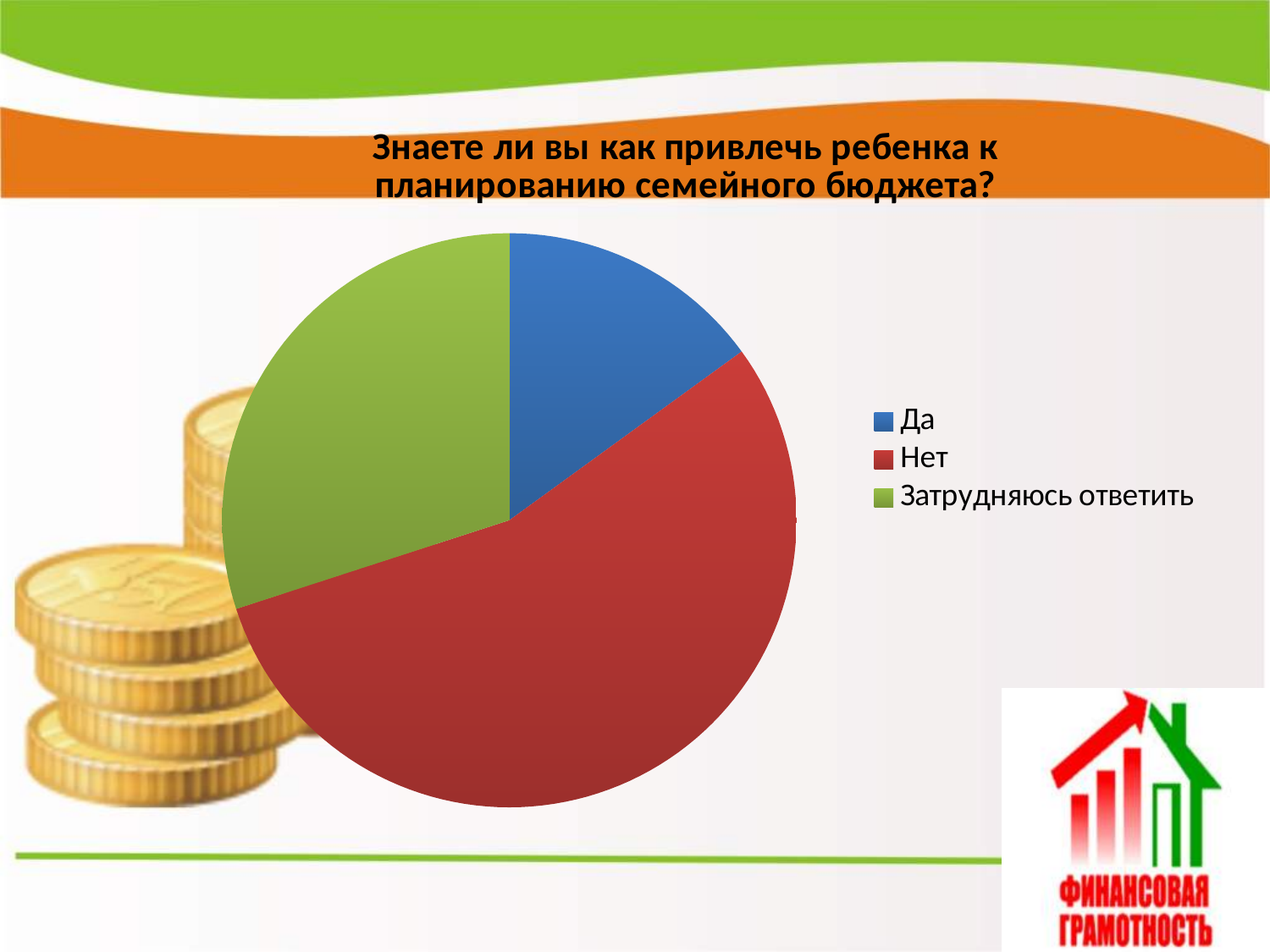
Which category has the smallest slice of the pie chart? Да What colour is the slice for Затрудняюсь ответить in the pie chart? green Which slice is larger, Да or Нет? Нет How many slices does the pie chart have? 3 Which category has the largest slice of the pie chart? Нет Which slice is larger, Затрудняюсь ответить or Да? Затрудняюсь ответить What kind of chart is shown on the slide? pie chart What is the title of the chart on the slide? Знаете ли вы как привлечь ребенка к планированию семейного бюджета? Which slice is larger, Нет or Затрудняюсь ответить? Нет How many entries does the legend of the pie chart list? 3